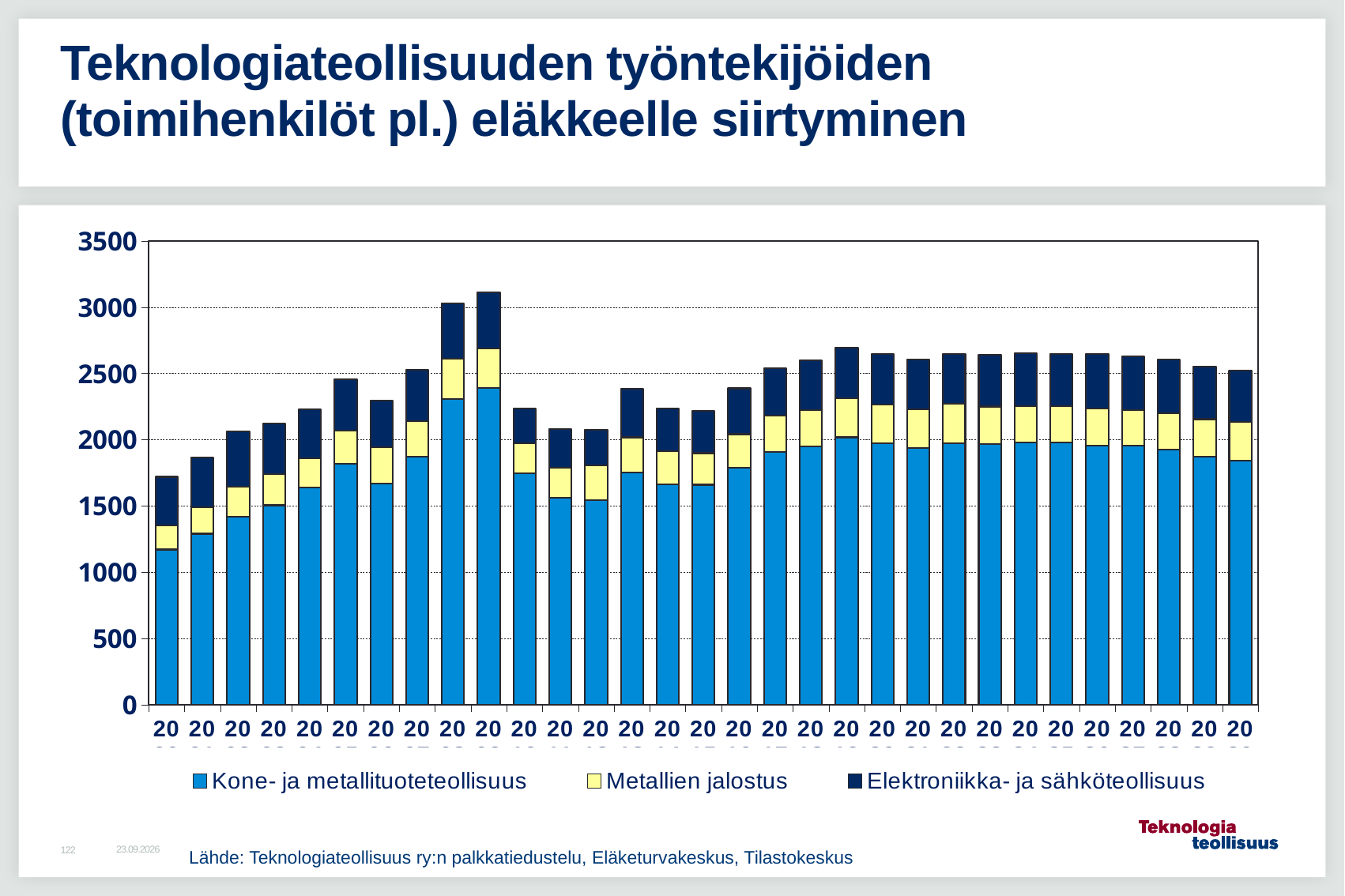
Which series forms the bottom (largest) segment of every stacked bar? Kone- ja metallituoteteollisuus Is the total of the tallest stacked bar greater or less than 3000? greater Which series is shown in yellow in the legend? Metallien jalostus Is the total of the rightmost bar greater or less than 2000? greater Is the total of the leftmost bar greater or less than 1500? greater Do the bar totals rise or fall across the first five bars from the left? rise How many stacked bars are plotted in the chart? 31 What kind of chart is shown on the slide? Stacked bar chart Which series is shown in dark navy blue in the legend? Elektroniikka- ja sähköteollisuus How many series does the legend list? 3 What is the highest value shown on the vertical axis? 3500